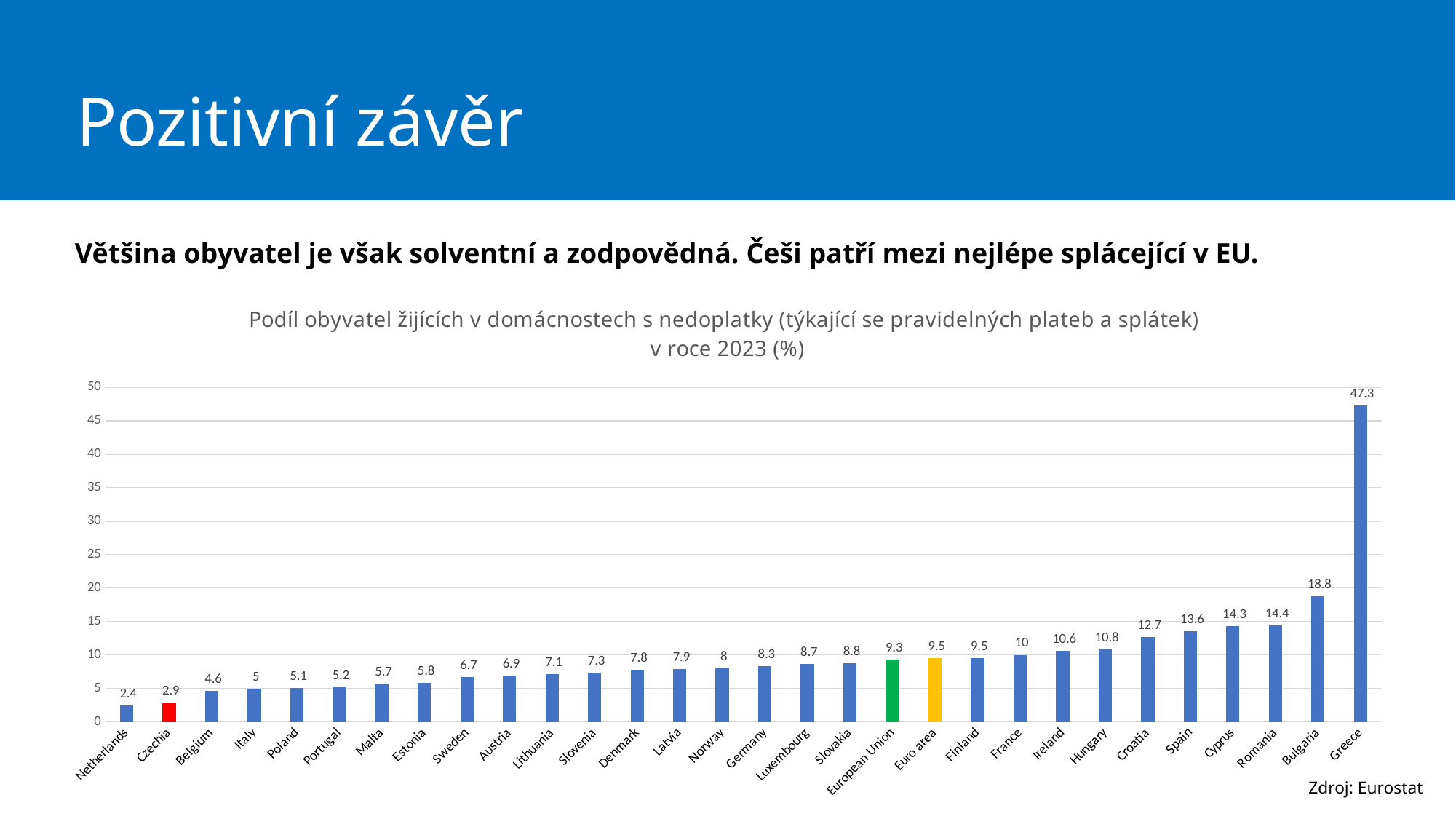
Which bar is coloured red? Czechia Is the value for Bulgaria greater or less than 15? greater What is the value for Czechia? 2.9 What is the value for Euro area? 9.5 Which country has the lowest value? Netherlands What is the difference between the values for Greece and Bulgaria? 28.5 What is the value for the European Union? 9.3 How many bars are shown in the chart? 30 What is the value for Greece? 47.3 Which country has the highest value? Greece Which has a larger value, Spain or Croatia? Spain What kind of chart is shown on the slide? Bar chart